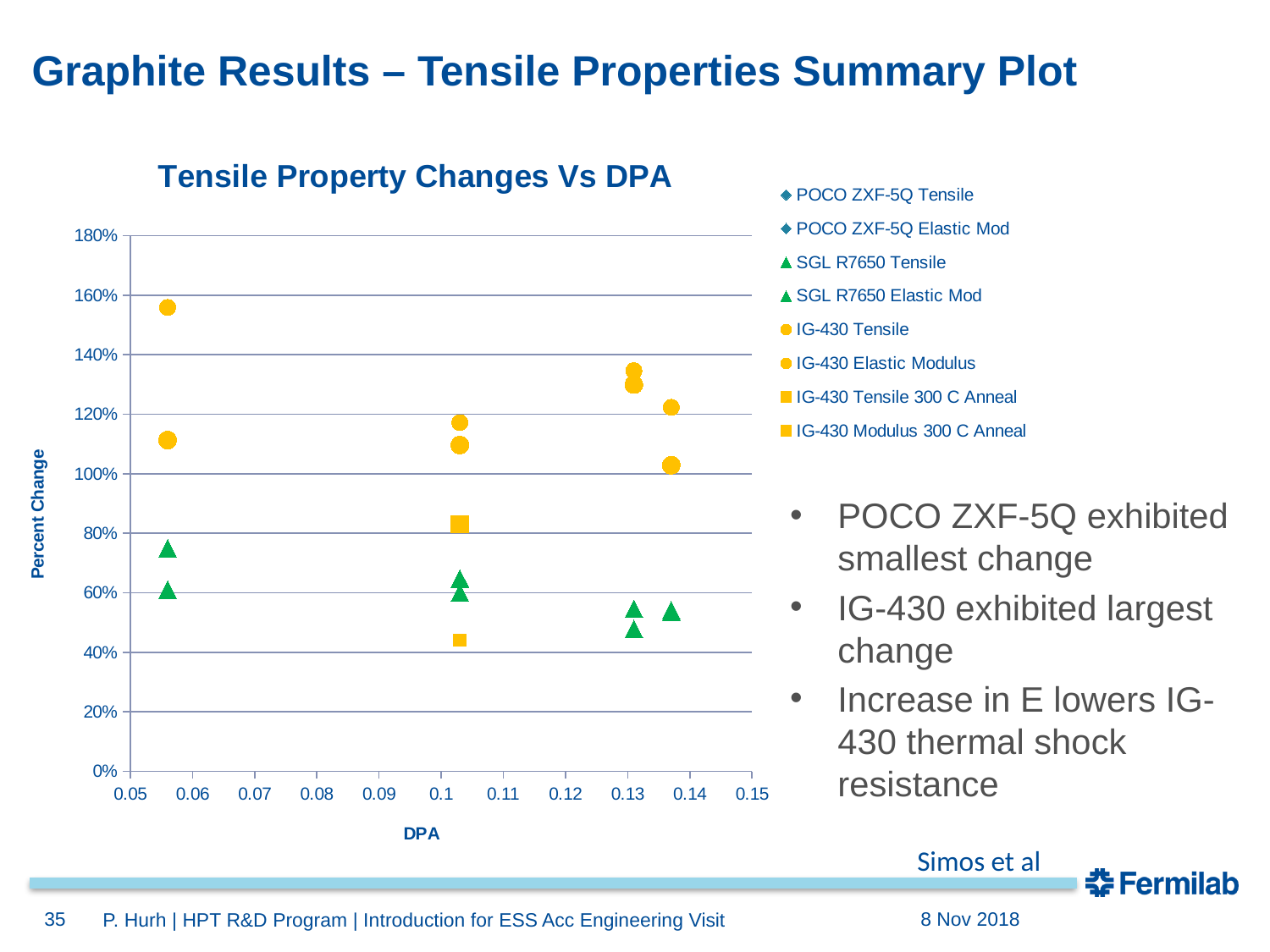
How many series does the legend of the chart list? 8 Is the highest yellow circle point on the chart greater or less than 140%? greater What is the title of the chart? Tensile Property Changes Vs DPA Which marker group reaches the highest percent change on the chart, the yellow circles (IG-430) or the green triangles (SGL R7650)? Yellow circles (IG-430) What kind of chart is shown on the slide? Scatter chart Is the lower yellow square point (IG-430 300 C Anneal) greater or less than 60%? less Is the upper yellow square point (IG-430 300 C Anneal) greater or less than 100%? less What is the label of the vertical axis of the chart? Percent Change How many yellow square (IG-430 300 C Anneal) points are plotted on the chart? 2 Do the green triangle (SGL R7650) points generally rise or fall as DPA increases? Fall